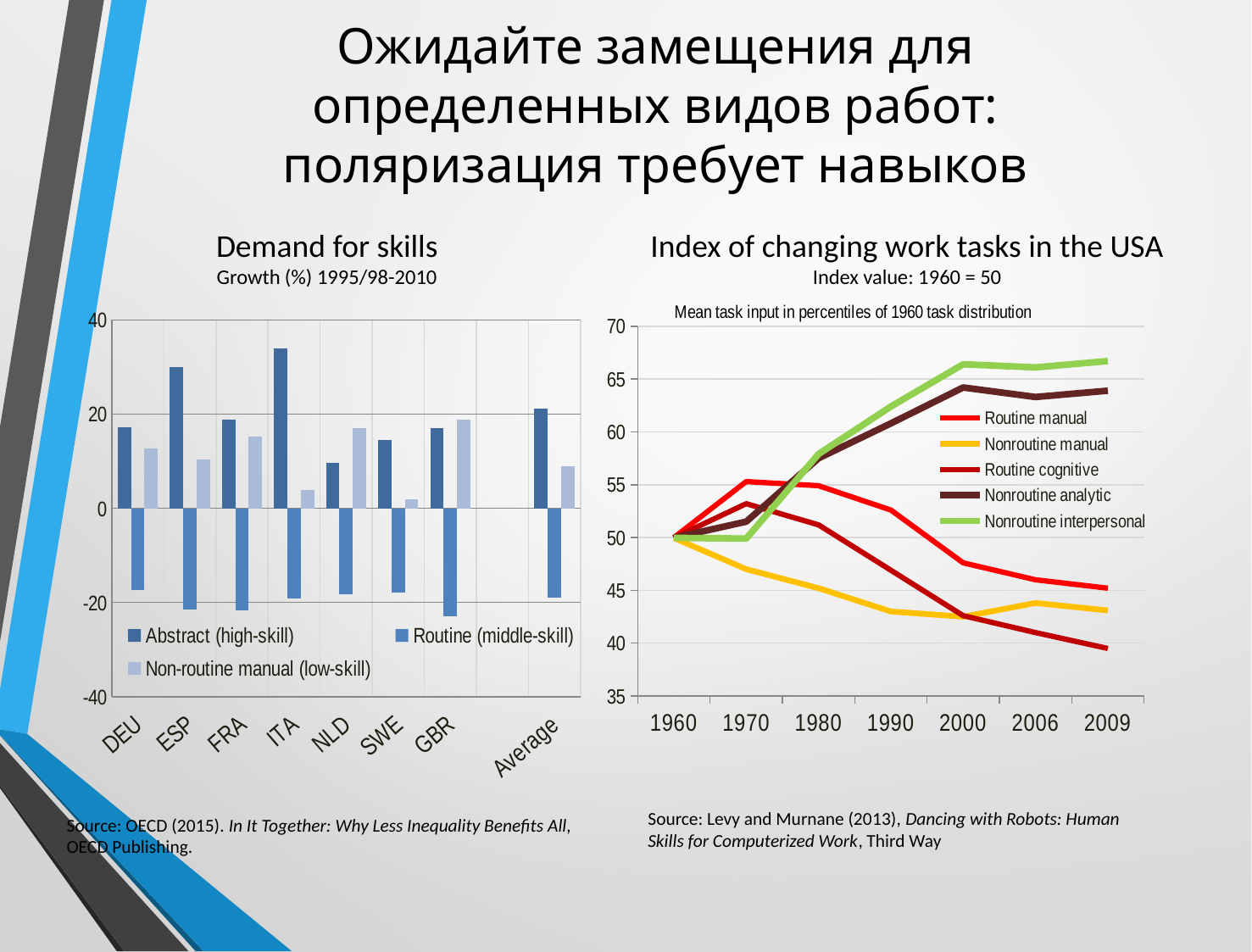
In the 'Demand for skills' chart, which category has the highest Abstract (high-skill) value? ITA In the 'Index of changing work tasks in the USA' chart, which series has the highest value in 2009? Nonroutine interpersonal In the 'Demand for skills' chart, which is larger: the Abstract (high-skill) value for ESP or for NLD? ESP In the 'Index of changing work tasks in the USA' chart, does the Routine manual series rise or fall from 1980 to 2009? fall How many countries/categories are shown on the x axis of the 'Demand for skills' chart? 8 What kind of chart is the 'Index of changing work tasks in the USA' chart on the right? line chart How many series does the legend of the 'Index of changing work tasks in the USA' chart list? 5 In the 'Demand for skills' chart, is the Abstract (high-skill) value for ESP greater or less than 20? greater In the 'Index of changing work tasks in the USA' chart, is the Routine cognitive value in 2009 greater or less than 40? less What kind of chart is the 'Demand for skills' chart on the left? bar chart How many series does the legend of the 'Demand for skills' chart list? 3 In the 'Demand for skills' chart, is the Routine (middle-skill) value for ITA greater or less than -10? less